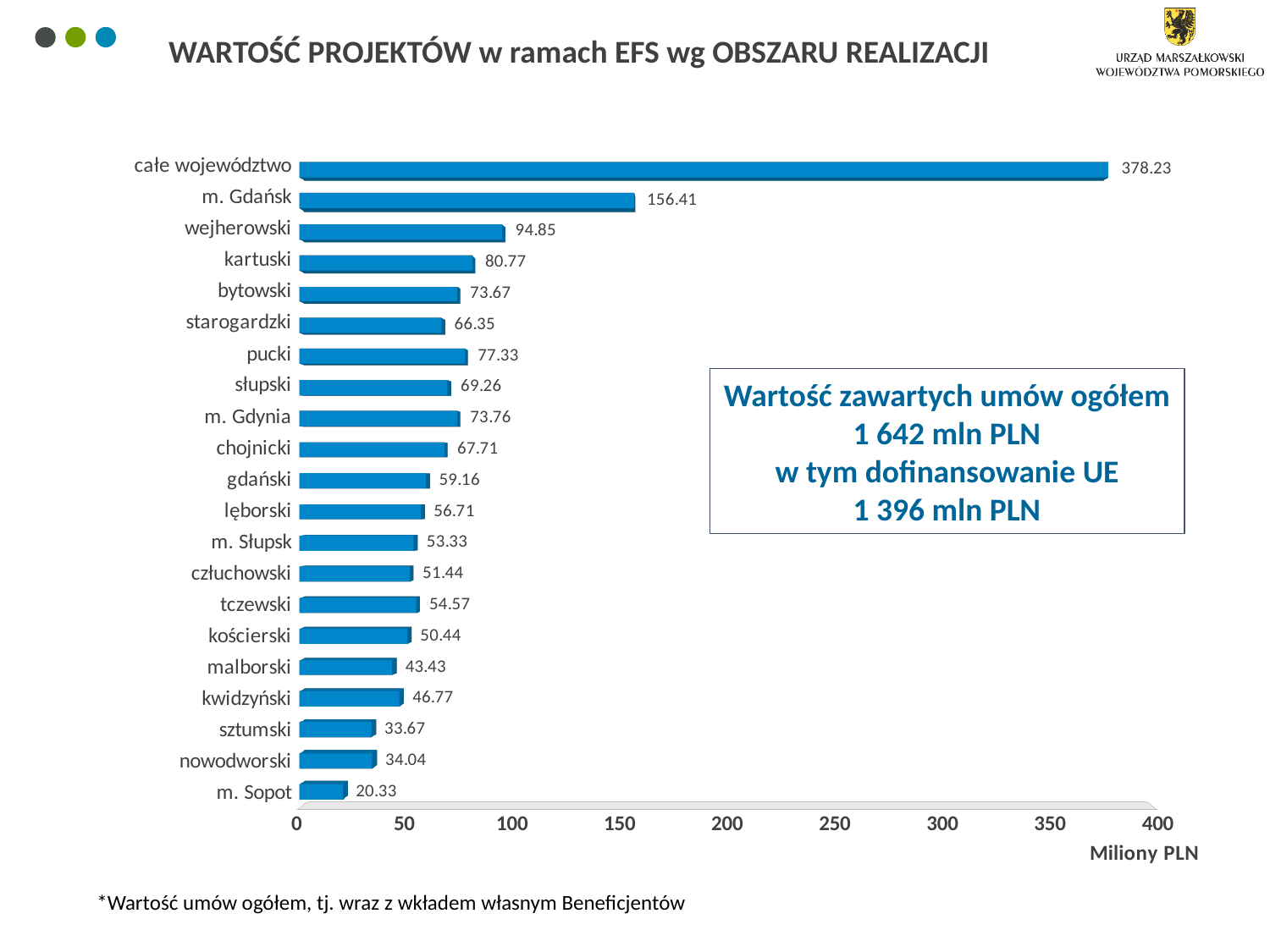
Which is larger, the value for pucki or the value for bytowski? pucki What is the value for kartuski? 80.77 According to the text box on the slide, what is the total value of concluded contracts (Wartość zawartych umów ogółem)? 1 642 mln PLN Which category has the lowest value? m. Sopot What is the value for m. Sopot? 20.33 What kind of chart is shown on the slide? bar chart Which category has the highest value? całe województwo How many categories are shown on the chart? 21 What is the difference between the values for m. Gdańsk and wejherowski? 61.56 What unit is shown on the x axis of the chart? Miliony PLN Is the value for wejherowski greater or less than 100? less What is the value for m. Gdańsk? 156.41